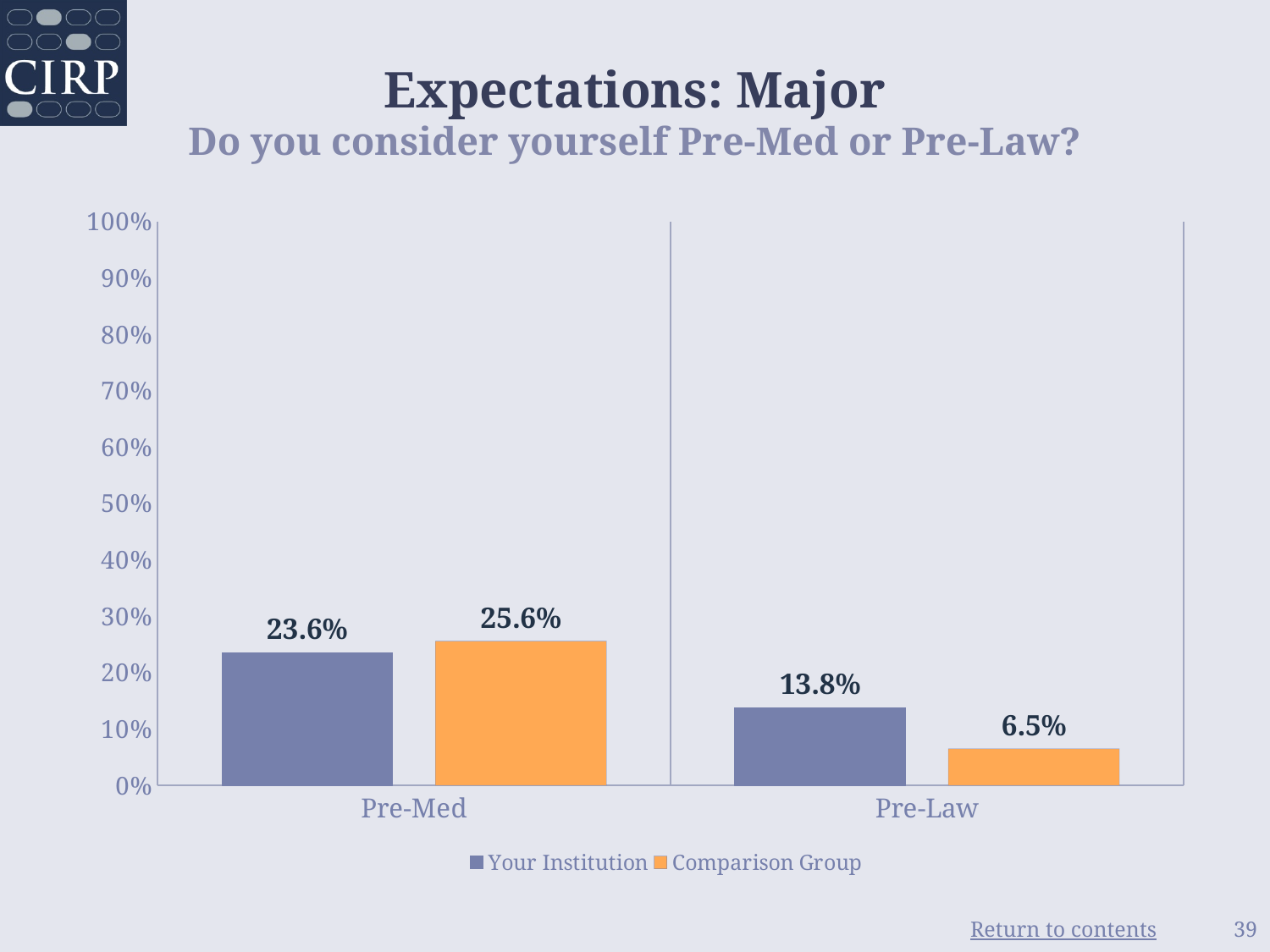
What kind of chart is shown on the slide? bar chart Is the value for Comparison Group in the Pre-Law category greater or less than 10%? less How many series does the legend list? 2 What is the value for Your Institution in the Pre-Med category? 23.6% Which bar on the chart has the lowest value? Comparison Group, Pre-Law Which series has the highest value in the Pre-Med category? Comparison Group Which is larger: Your Institution for Pre-Med or Your Institution for Pre-Law? Your Institution for Pre-Med What is the difference between Your Institution and Comparison Group in the Pre-Law category? 7.3% What is the value for Comparison Group in the Pre-Law category? 6.5% What is the value for Your Institution in the Pre-Law category? 13.8% How many categories are shown on the x axis? 2 What is the difference between Comparison Group and Your Institution in the Pre-Med category? 2.0%